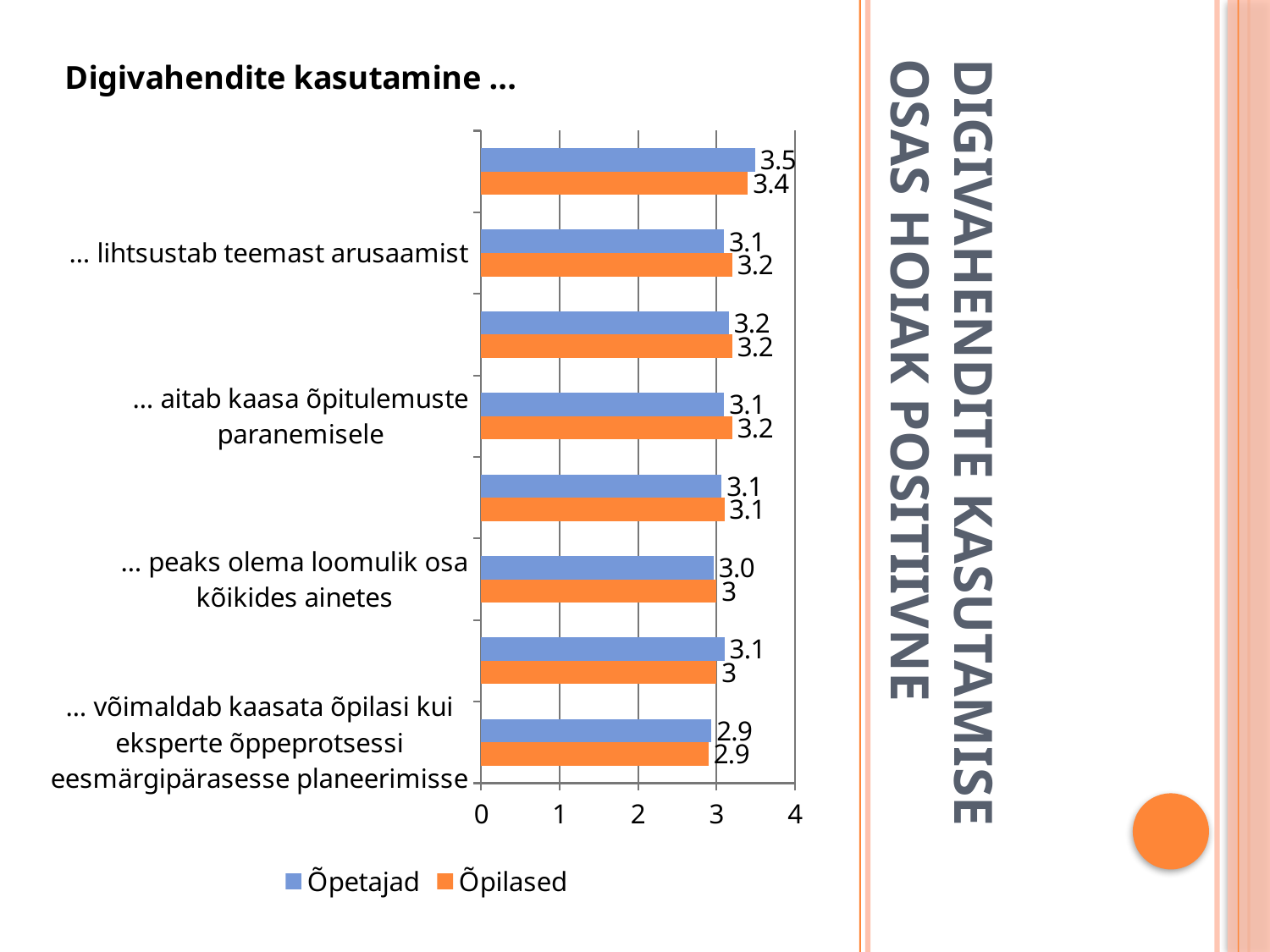
What is the value for Õpilased for "… lihtsustab teemast arusaamist"? 3.2 What is the highest value shown by any data label on the chart? 3.5 What is the value for Õpetajad for "… võimaldab kaasata õpilasi kui eksperte õppeprotsessi eesmärgipärasesse planeerimisse"? 2.9 What colour represents Õpilased in the chart? Orange For "… aitab kaasa õpitulemuste paranemisele", what is the difference between the Õpilased and Õpetajad values? 0.1 What kind of chart is shown on the slide? Bar chart How many series does the legend list? 2 What is the value for Õpetajad for "… peaks olema loomulik osa kõikides ainetes"? 3.0 What is the value for Õpilased for "… aitab kaasa õpitulemuste paranemisele"? 3.2 What is the lowest value shown by any data label on the chart? 2.9 For "… lihtsustab teemast arusaamist", which series has the larger value, Õpetajad or Õpilased? Õpilased What is the value for Õpetajad for "… lihtsustab teemast arusaamist"? 3.1